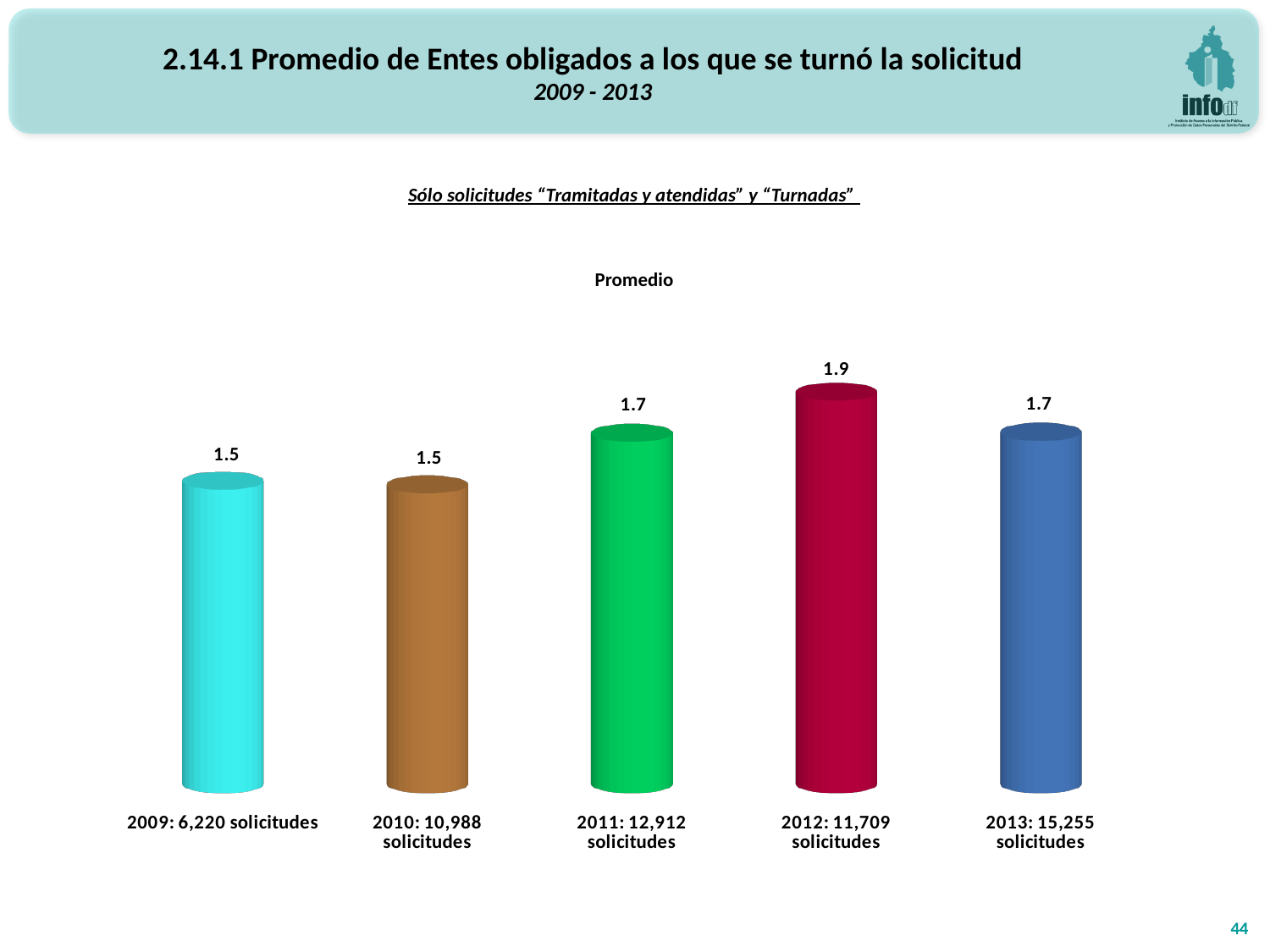
How many solicitudes are indicated in the category label for 2013? 15,255 What is the difference between the average values for 2011 and 2009? 0.2 How many years (bars) are plotted in the chart? 5 What kind of chart is shown on the slide? Bar chart What is the difference between the average values for 2012 and 2010? 0.4 What is the title of the chart? Promedio What is the average (Promedio) value shown for 2009? 1.5 Which year has the highest average value? 2012 What is the average value shown for 2012? 1.9 Which is larger, the average value for 2011 or for 2010? 2011 What is the average value shown for 2013? 1.7 What colour is the bar for 2012? Red